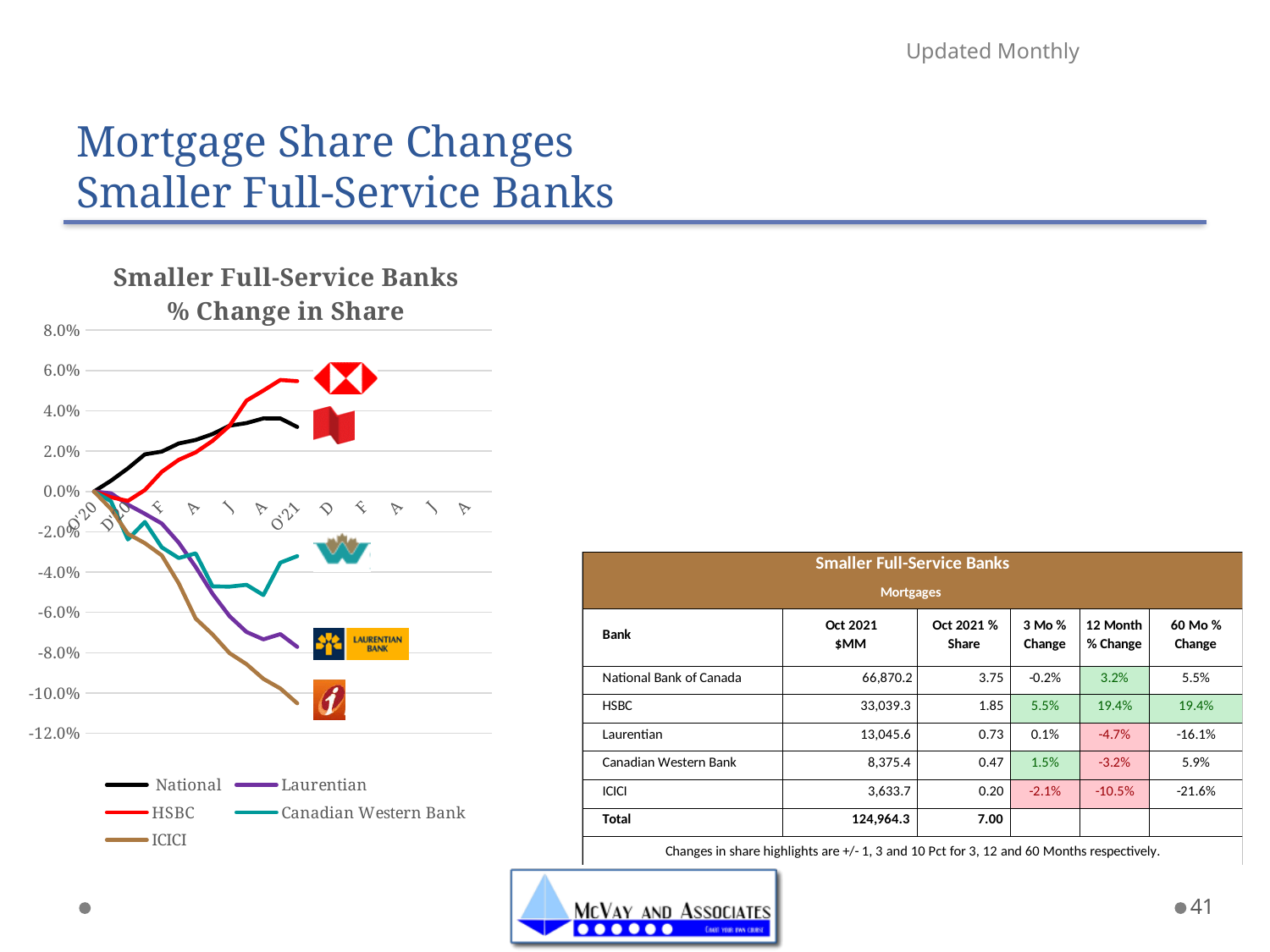
What kind of chart is shown on the slide? line chart What colour is the HSBC line in the chart? red Which series has the lowest value at the right end of the chart? ICICI Is the final value for ICICI greater or less than -8.0%? less At the right end of the chart, which is higher: National or Laurentian? National Is the final value for HSBC greater or less than 4.0%? greater Which series has the highest value at the right end of the chart? HSBC Does the HSBC line rise or fall from left to right across the chart? rise What is the title of the chart? Smaller Full-Service Banks % Change in Share Does the ICICI line rise or fall from left to right across the chart? fall How many series does the legend of the chart list? 5 Is the final value for Laurentian greater or less than -6.0%? less